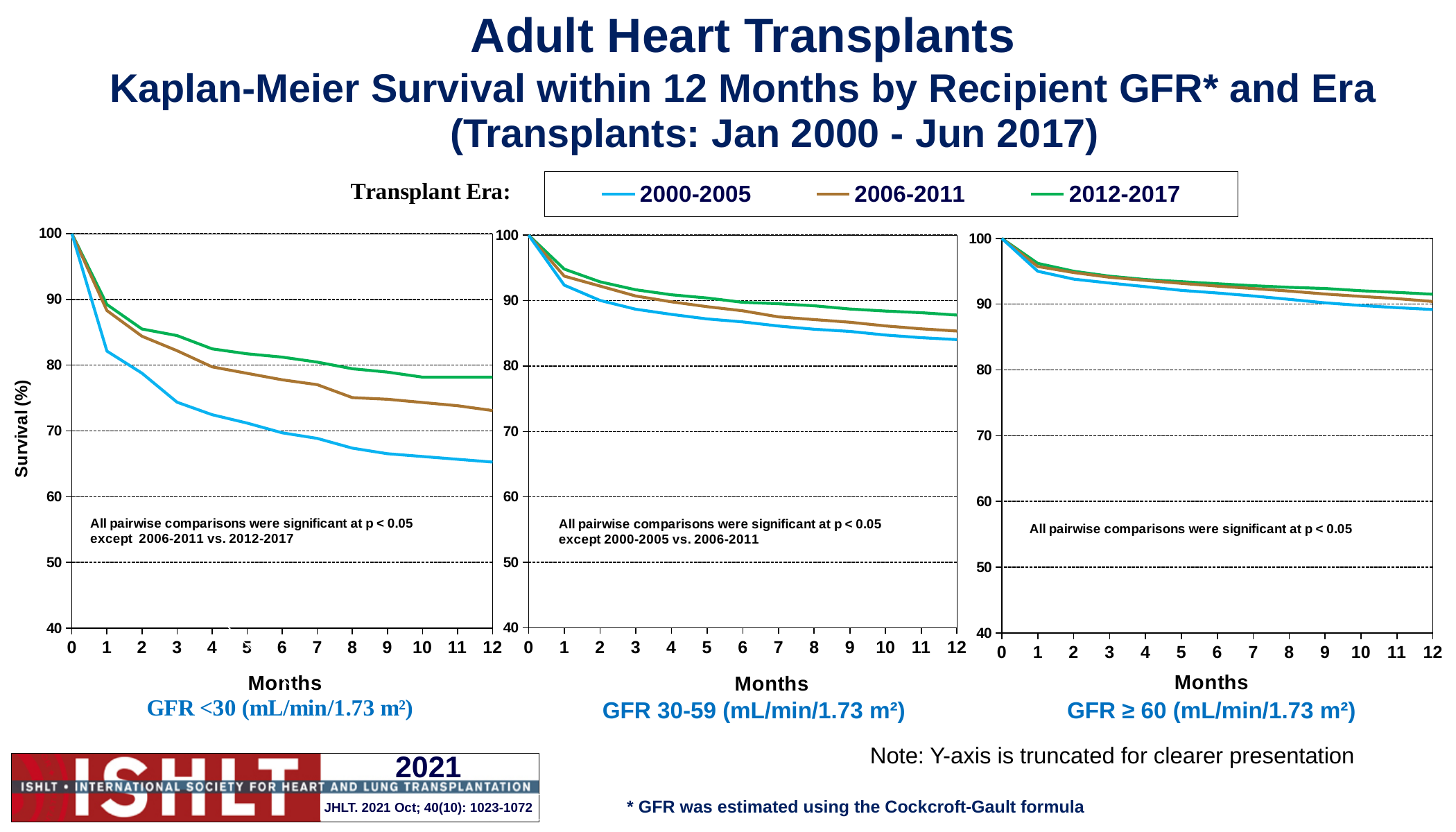
In the GFR <30 (mL/min/1.73 m²) chart, what is the survival value for the 2000-2005 era at month 0? 100 In the GFR 30-59 (mL/min/1.73 m²) chart, at 12 months, which era has higher survival: 2012-2017 or 2000-2005? 2012-2017 How many survival charts are shown on the slide? 3 In the GFR <30 (mL/min/1.73 m²) chart, is the survival for the 2000-2005 era at 12 months greater or less than 70? less What kind of chart is used in the GFR <30 (mL/min/1.73 m²) panel? line chart In the GFR <30 (mL/min/1.73 m²) chart, is the survival for the 2012-2017 era at 12 months greater or less than 80? less In the GFR ≥ 60 (mL/min/1.73 m²) chart, does survival rise or fall as months increase? fall How many transplant eras does the legend list? 3 What is the label on the y-axis of the charts? Survival (%) In the GFR <30 (mL/min/1.73 m²) chart, which era has the highest survival at 12 months? 2012-2017 In the GFR <30 (mL/min/1.73 m²) chart, which era has the lowest survival at 12 months? 2000-2005 In the GFR 30-59 (mL/min/1.73 m²) chart, is the survival for the 2000-2005 era at 12 months greater or less than 80? greater